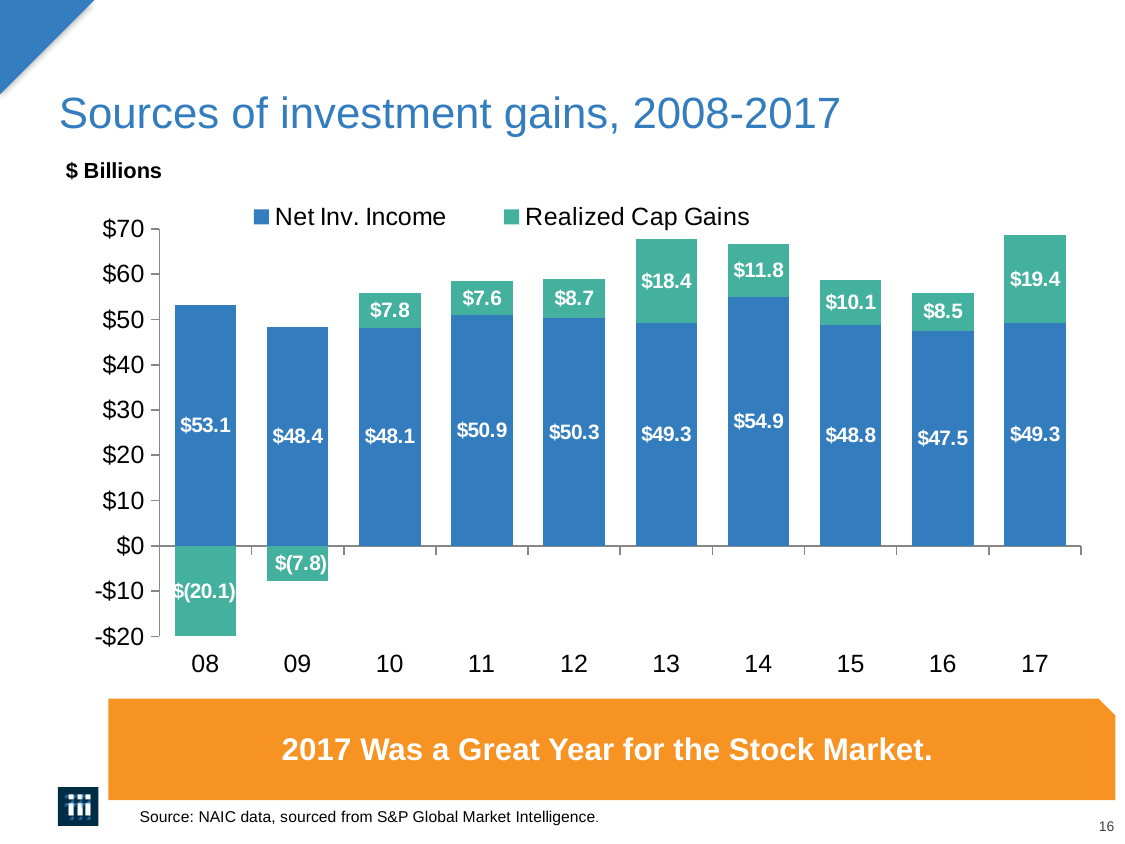
How many series does the legend list? 2 What is the Net Inv. Income value for 2014? $54.9 What kind of chart is shown on the slide? Stacked bar chart Which year has the highest Realized Cap Gains? 17 Which year has the lowest Net Inv. Income? 16 What is the total of the stacked bar for 2017 (Net Inv. Income plus Realized Cap Gains)? $68.7 Which year has the highest Net Inv. Income? 14 What is the Realized Cap Gains value for 2017? $19.4 What is the difference between Realized Cap Gains in 2017 and in 2013? $1.0 Which is larger, Net Inv. Income in 2014 or in 2016? 2014 What is the Realized Cap Gains value for 2008? $(20.1) How many years are shown on the x axis? 10